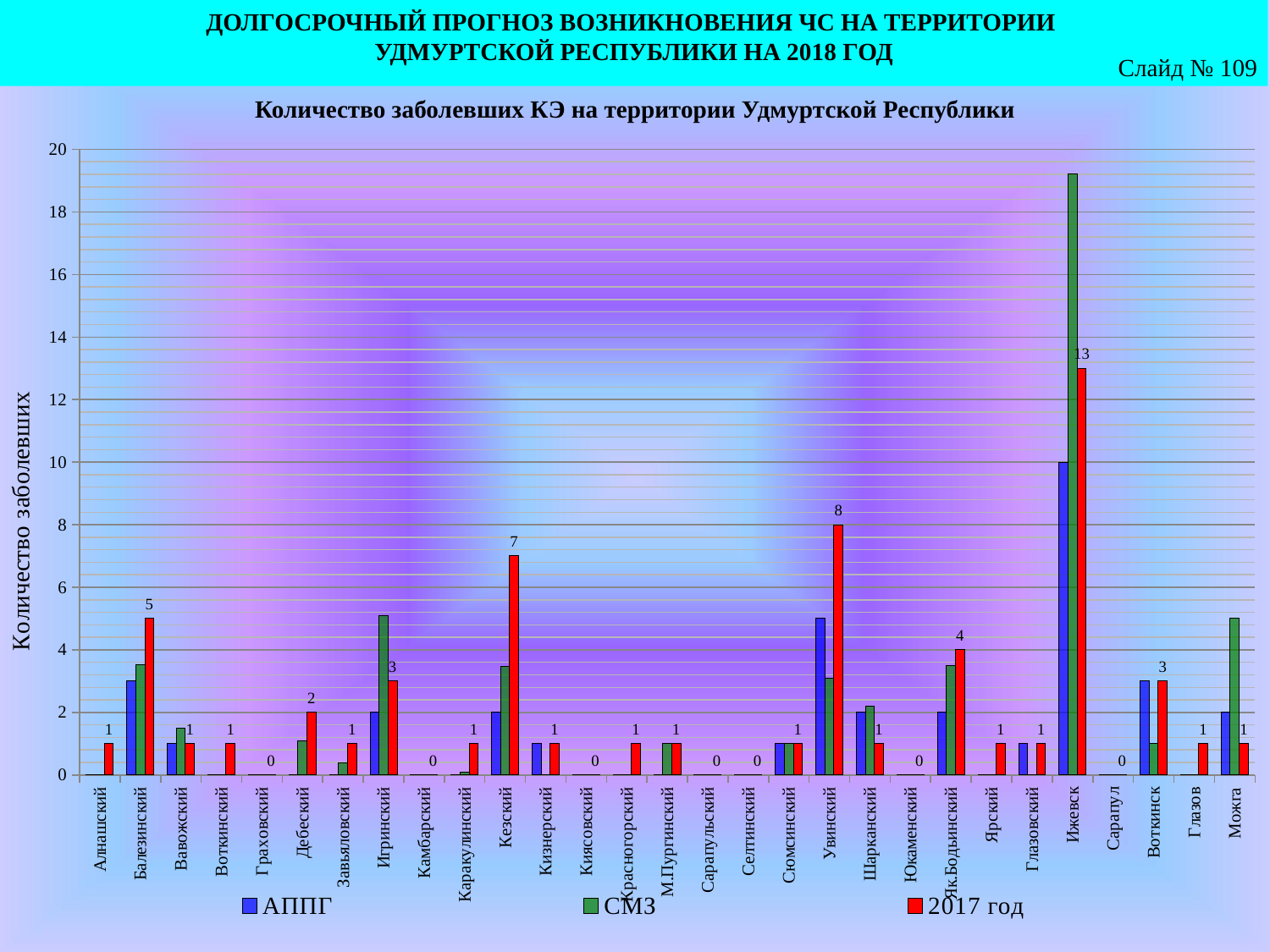
Is the СМЗ value for Ижевск greater or less than 18? greater What is the value for Увинский in the 2017 год series? 8 What kind of chart is shown on the slide? bar chart How many categories are shown on the x axis? 29 Which category has the highest value in the 2017 год series? Ижевск Which is larger in the 2017 год series: Балезинский or Як.Бодьинский? Балезинский Is the АППГ value for Ижевск greater or less than 8? greater What is the title of the chart? Количество заболевших КЭ на территории Удмуртской Республики What is the difference between the 2017 год values for Ижевск and Увинский? 5 How many series does the legend list? 3 What is the value for Кезский in the 2017 год series? 7 What is the value for Ижевск in the 2017 год series? 13